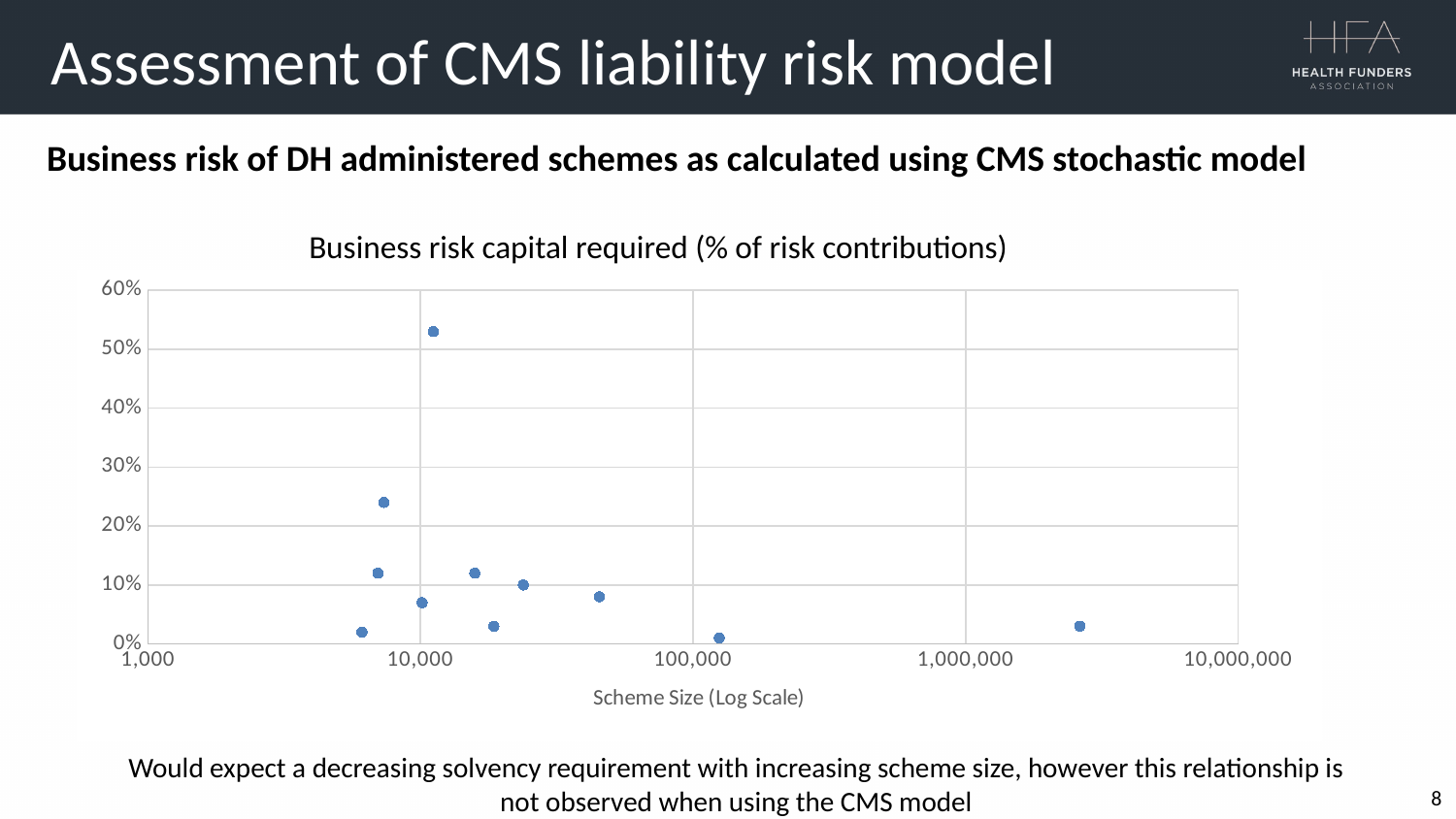
Is the value of the point with the largest scheme size (near 1,000,000 to 10,000,000) greater or less than 10%? less What is the highest value shown on the y axis? 60% What is the title of the chart? Business risk capital required (% of risk contributions) Does the chart show a clear decreasing trend in business risk capital as scheme size increases? No What is the label of the x axis of the chart? Scheme Size (Log Scale) Which point has the highest value: the one near 10,000 on the x axis or the one near 100,000? The one near 10,000 Is the value of the point located just above 100,000 on the x axis greater or less than 10%? less Is the value of the highest point on the chart greater or less than 50%? greater What kind of chart is shown on the slide? Scatter chart How many data points are plotted on the chart? 11